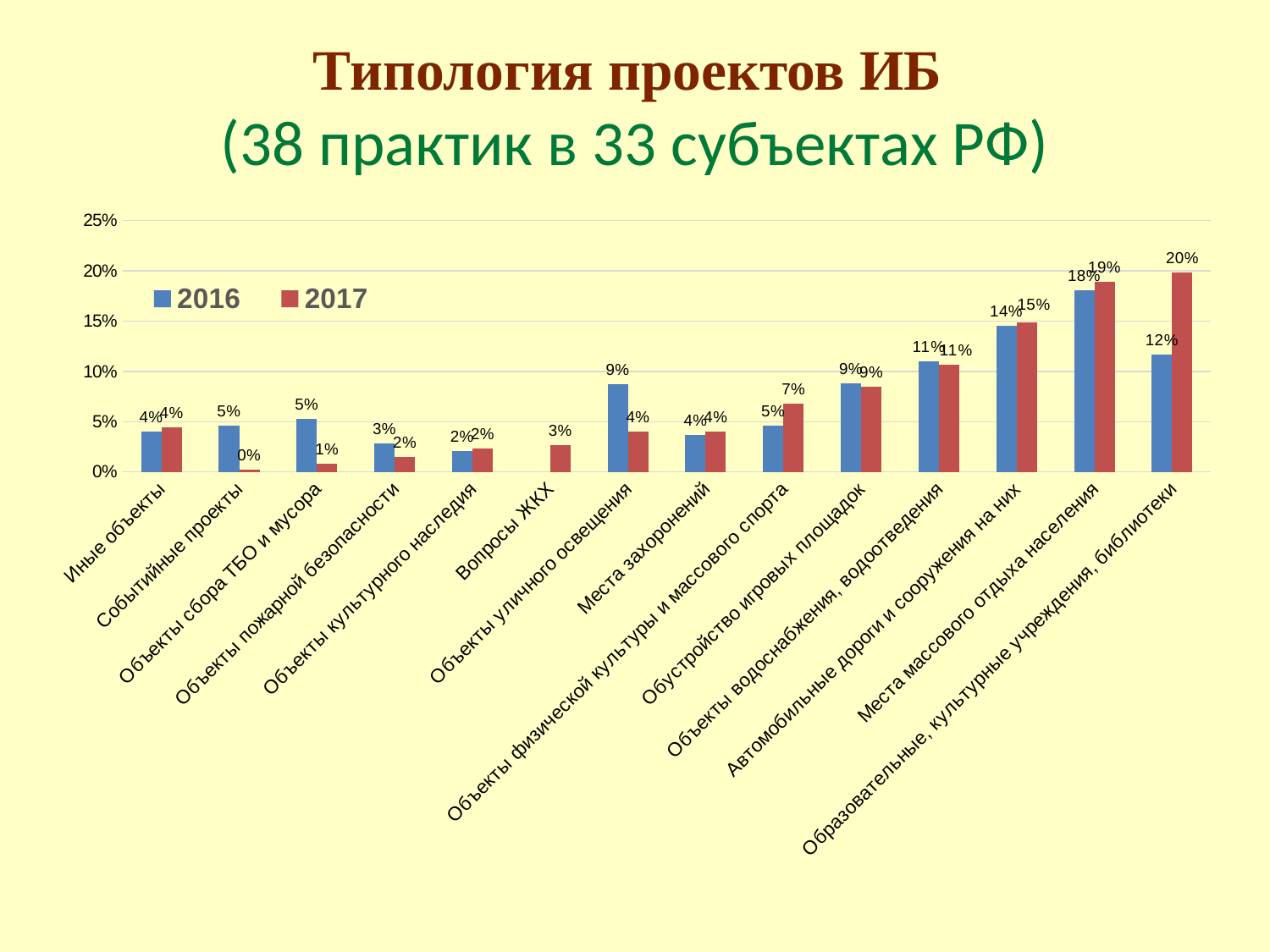
What are the two series named in the legend? 2016 and 2017 How many series does the legend list? 2 What is the 2017 value for Образовательные, культурные учреждения, библиотеки? 20% What is the difference between the 2017 and 2016 values for Образовательные, культурные учреждения, библиотеки? 8% Which category has the highest 2016 value? Места массового отдыха населения How many categories are shown on the x axis? 14 What kind of chart is shown on the slide? bar chart What is the 2017 value for Объекты физической культуры и массового спорта? 7% Which category has the lowest 2017 value? Событийные проекты Which category has the highest 2017 value? Образовательные, культурные учреждения, библиотеки What is the 2016 value for Объекты уличного освещения? 9% Which is larger for Объекты уличного освещения: the 2016 value or the 2017 value? 2016